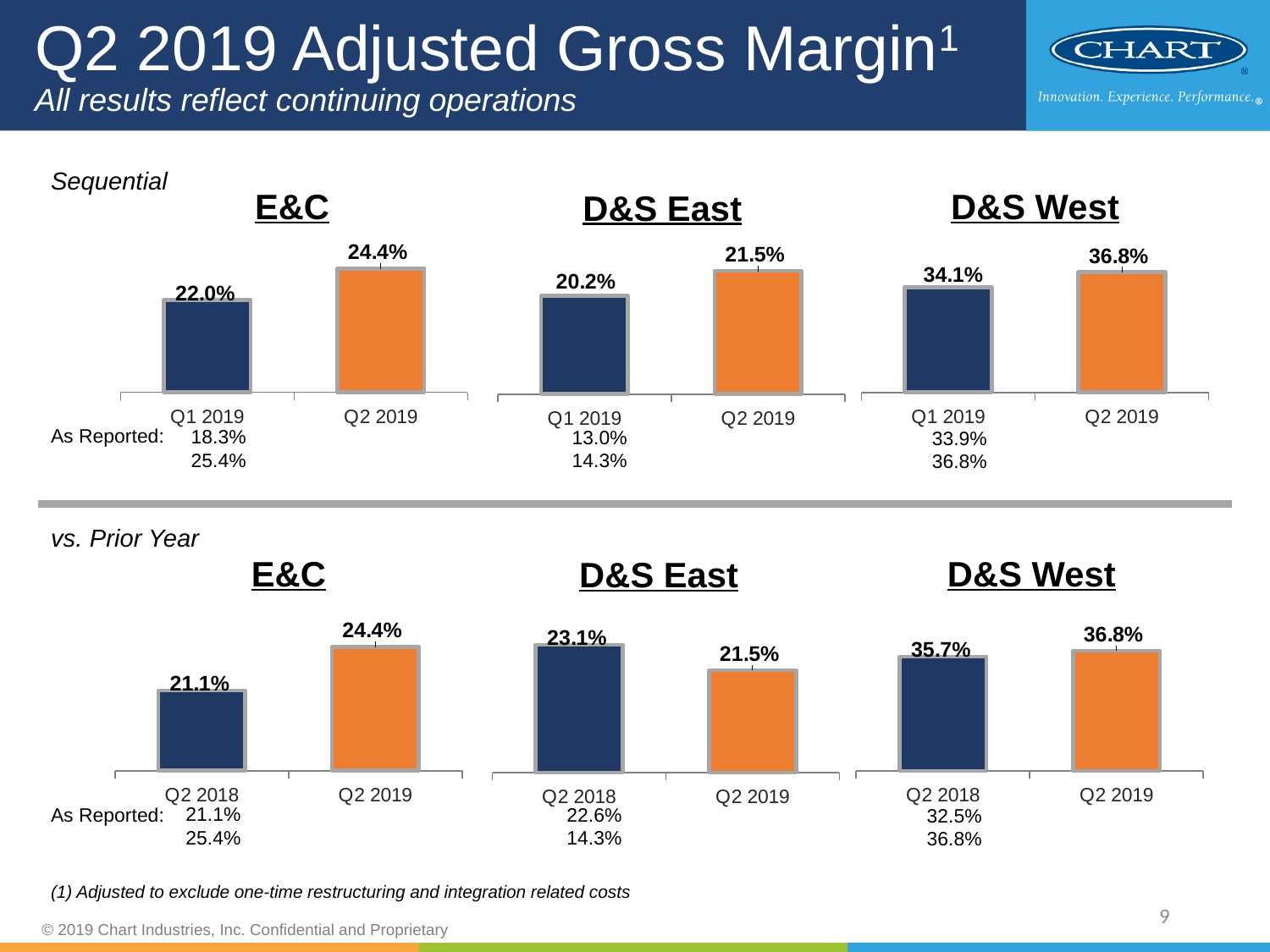
In the Sequential E&C chart, what is the adjusted gross margin for Q2 2019? 24.4% In the Sequential D&S East chart, what is the value for Q1 2019? 20.2% In the Sequential E&C chart, what is the difference between the Q2 2019 and Q1 2019 values? 2.4% What type of chart is used for the vs. Prior Year E&C chart? bar chart In the vs. Prior Year E&C chart, what is the value for Q2 2018? 21.1% In the vs. Prior Year D&S East chart, which quarter has the higher value, Q2 2018 or Q2 2019? Q2 2018 In the vs. Prior Year D&S West chart, what colour is the Q2 2019 bar? orange In the vs. Prior Year D&S West chart, what is the difference between the Q2 2019 and Q2 2018 values? 1.1% How many bars are shown in the Sequential D&S East chart? 2 In the vs. Prior Year D&S East chart, do the values rise or fall from Q2 2018 to Q2 2019? fall In the Sequential D&S West chart, what is the value for Q2 2019? 36.8% In the Sequential D&S West chart, which quarter has the lowest value? Q1 2019